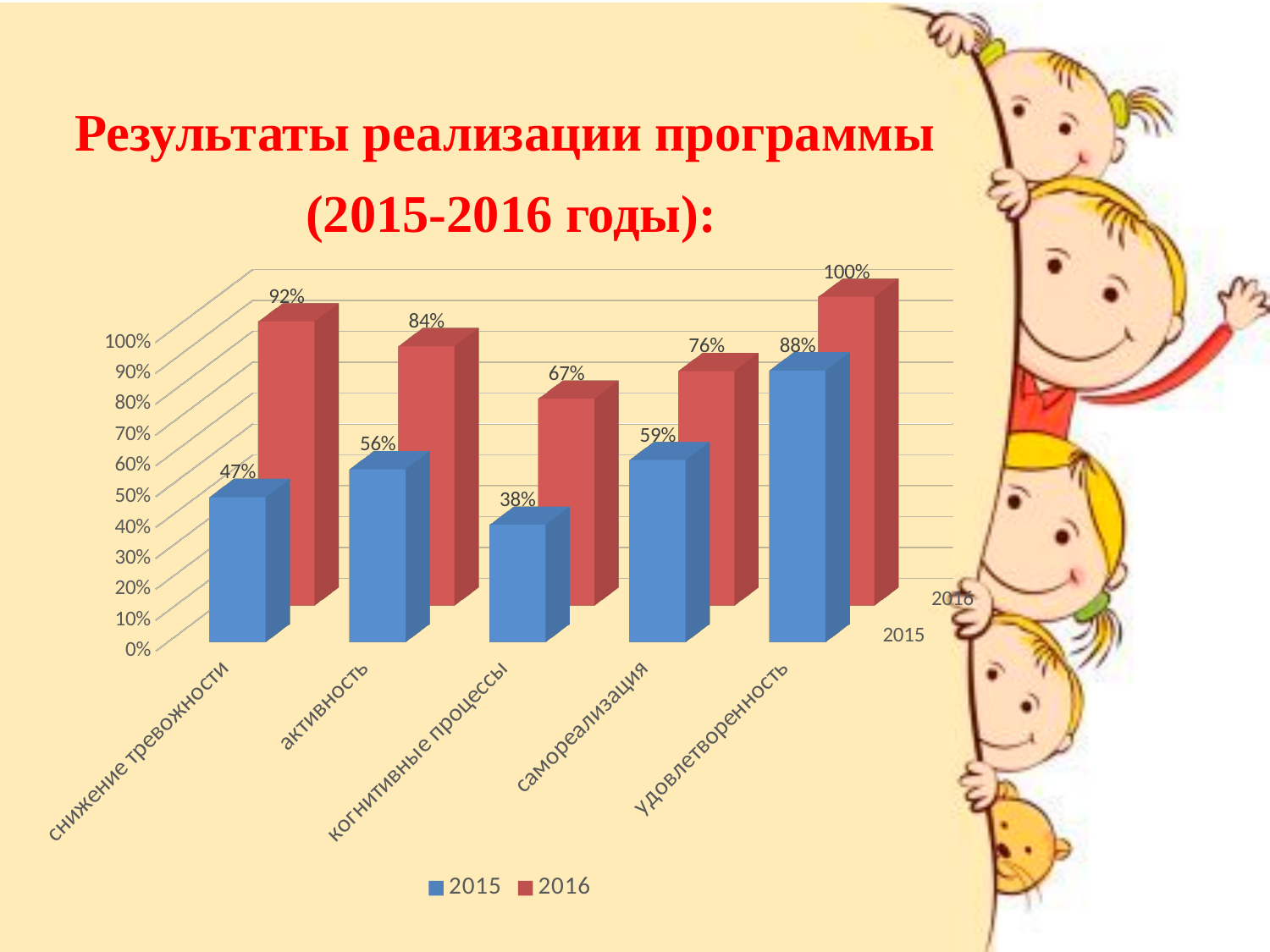
What is the 2016 value for когнитивные процессы? 67% Which colour represents the 2016 series? red Which category has the lowest 2015 value? когнитивные процессы What is the 2015 value for снижение тревожности? 47% What kind of chart is shown on the slide? bar chart What is the difference between the 2016 and 2015 values for снижение тревожности? 45% What is the difference between the 2016 and 2015 values for активность? 28% What is the 2016 value for удовлетворенность? 100% Which category has the highest 2016 value? удовлетворенность How many categories are shown on the x axis? 5 Which is larger: the 2015 value for самореализация or the 2015 value for активность? самореализация How many series does the legend list? 2